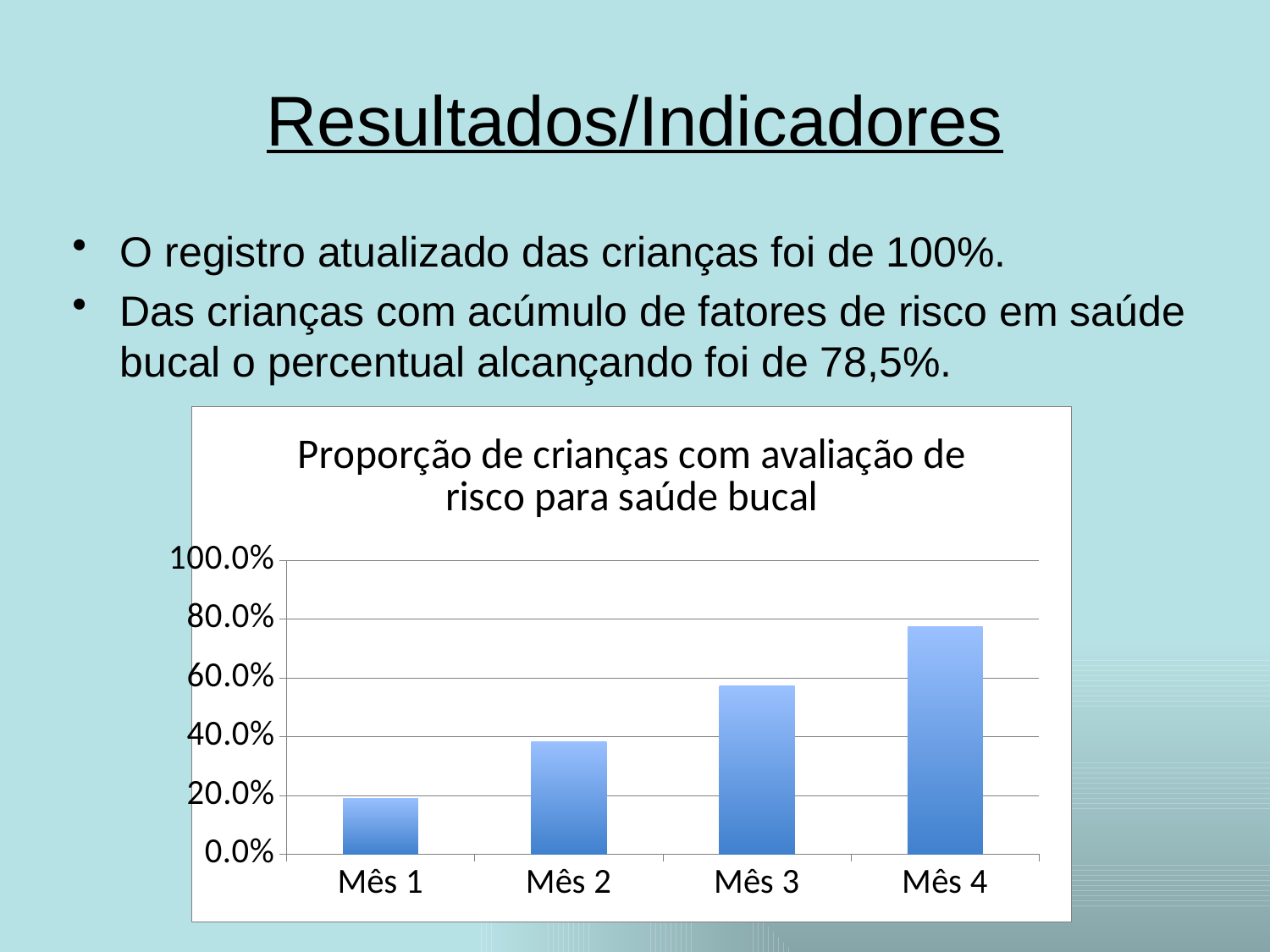
Is the value for Mês 4 greater or less than 60.0%? greater Which month has the highest value in the chart? Mês 4 What is the title of the chart? Proporção de crianças com avaliação de risco para saúde bucal What kind of chart is shown on the slide? bar chart Is the value for Mês 1 greater or less than 40.0%? less How many categories (months) are shown on the x axis of the chart? 4 Which is larger, the value for Mês 2 or the value for Mês 3? Mês 3 Which month has the lowest value in the chart? Mês 1 Is the value for Mês 3 greater or less than 40.0%? greater Which is larger, the value for Mês 1 or the value for Mês 4? Mês 4 Do the values rise or fall from Mês 1 to Mês 4? rise